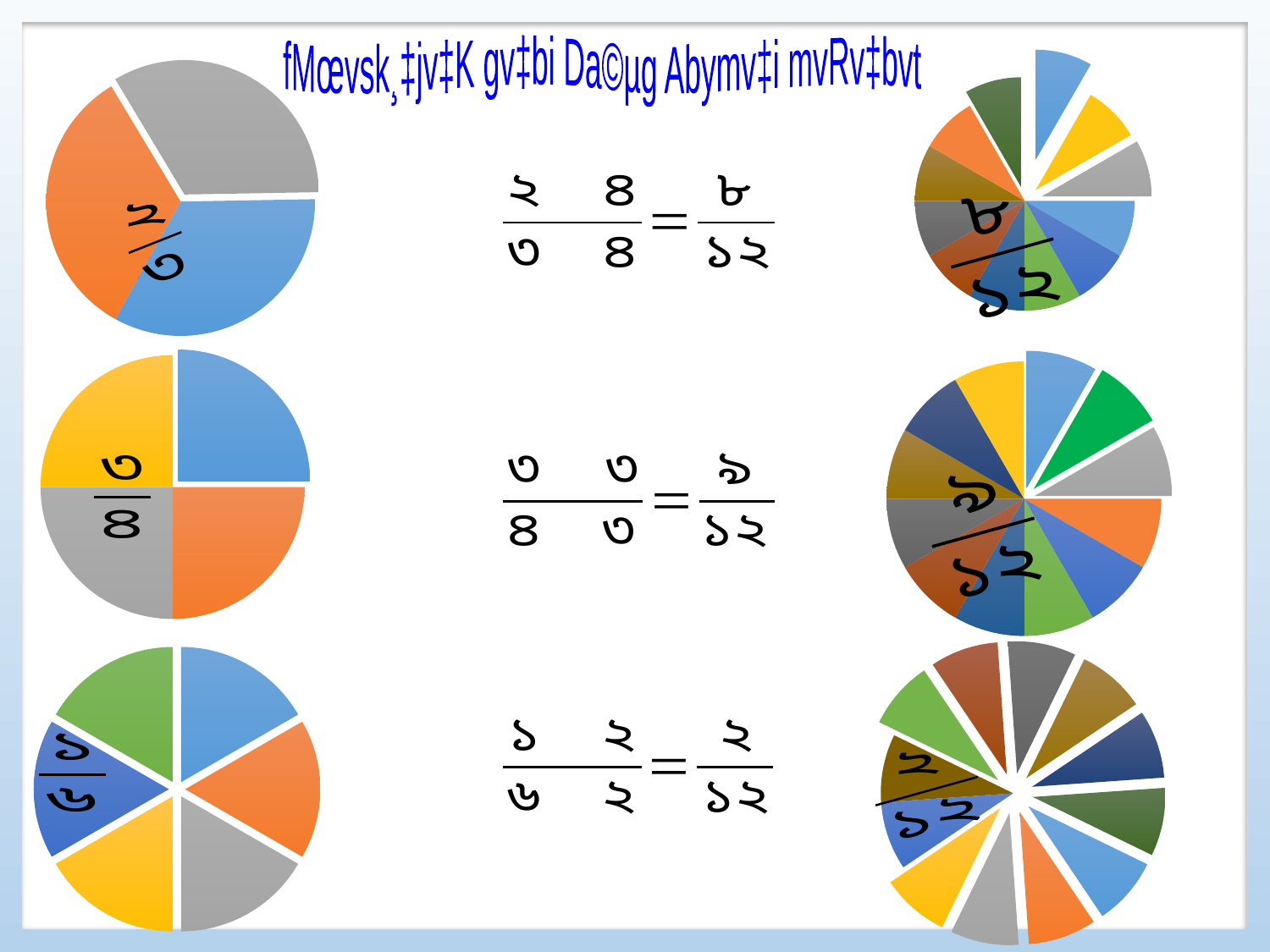
What fraction is written on the bottom-right pie chart? ২/১২ How many slices does the bottom-left pie chart have? 6 What kind of chart is the top-left chart on the slide? pie chart What fraction is written on the top-left pie chart? ২/৩ How many slices does the top-right pie chart have? 12 How many slices does the middle-right pie chart have? 12 What fraction is written on the bottom-left pie chart? ১/৬ What fraction is written on the middle-left pie chart? ৩/৪